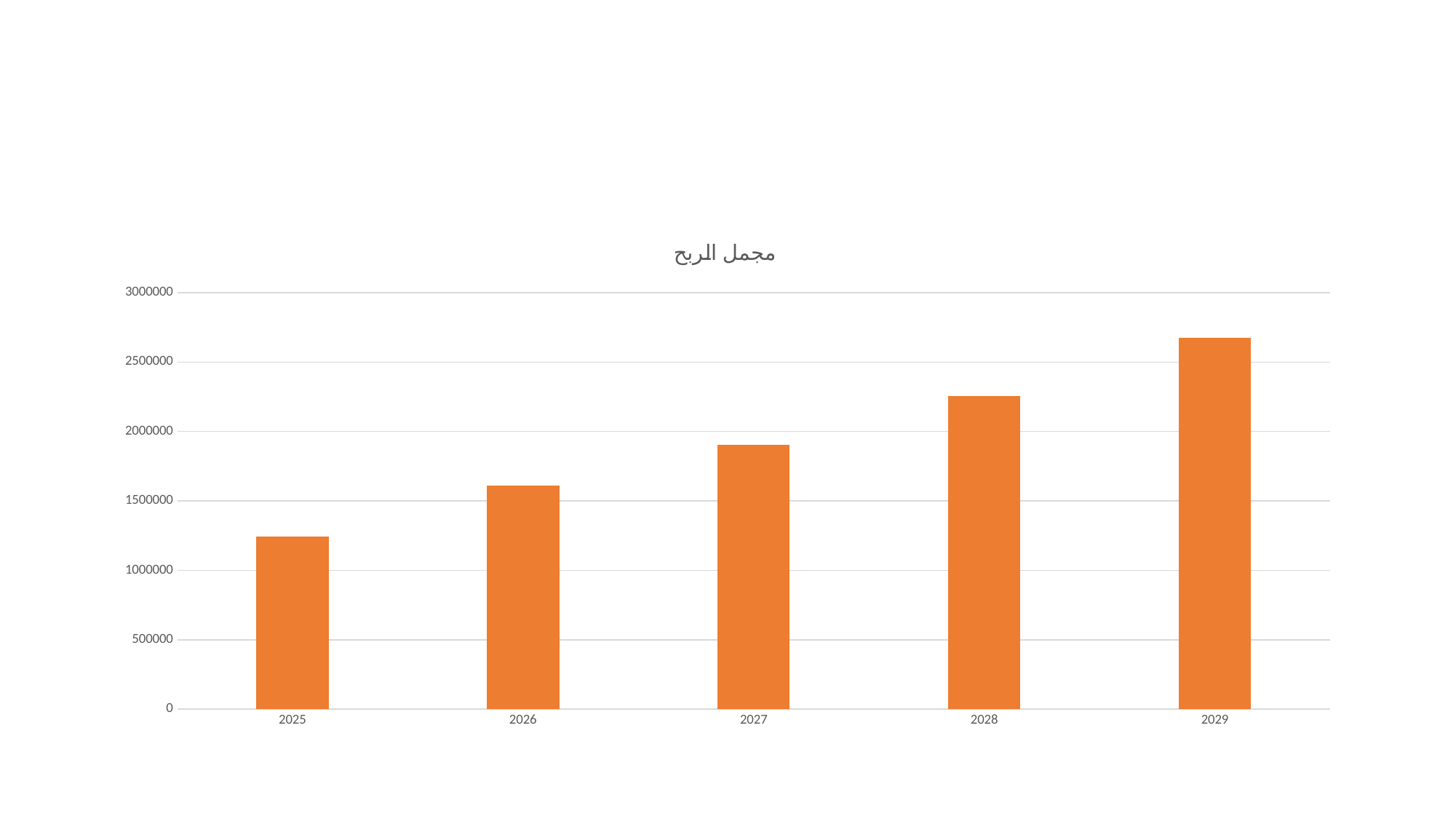
Which is larger, the value for 2026 or the value for 2028? 2028 What is the title of the chart? مجمل الربح Do the values rise or fall from 2025 to 2029? rise Which year has the highest bar in the chart? 2029 Is the value for 2028 greater or less than 2000000? greater Is the value for 2025 greater or less than 1500000? less Is the value for 2029 greater or less than 2500000? greater Which year has the lowest bar in the chart? 2025 How many years are shown on the x axis of the chart? 5 What kind of chart is shown on the slide? bar chart